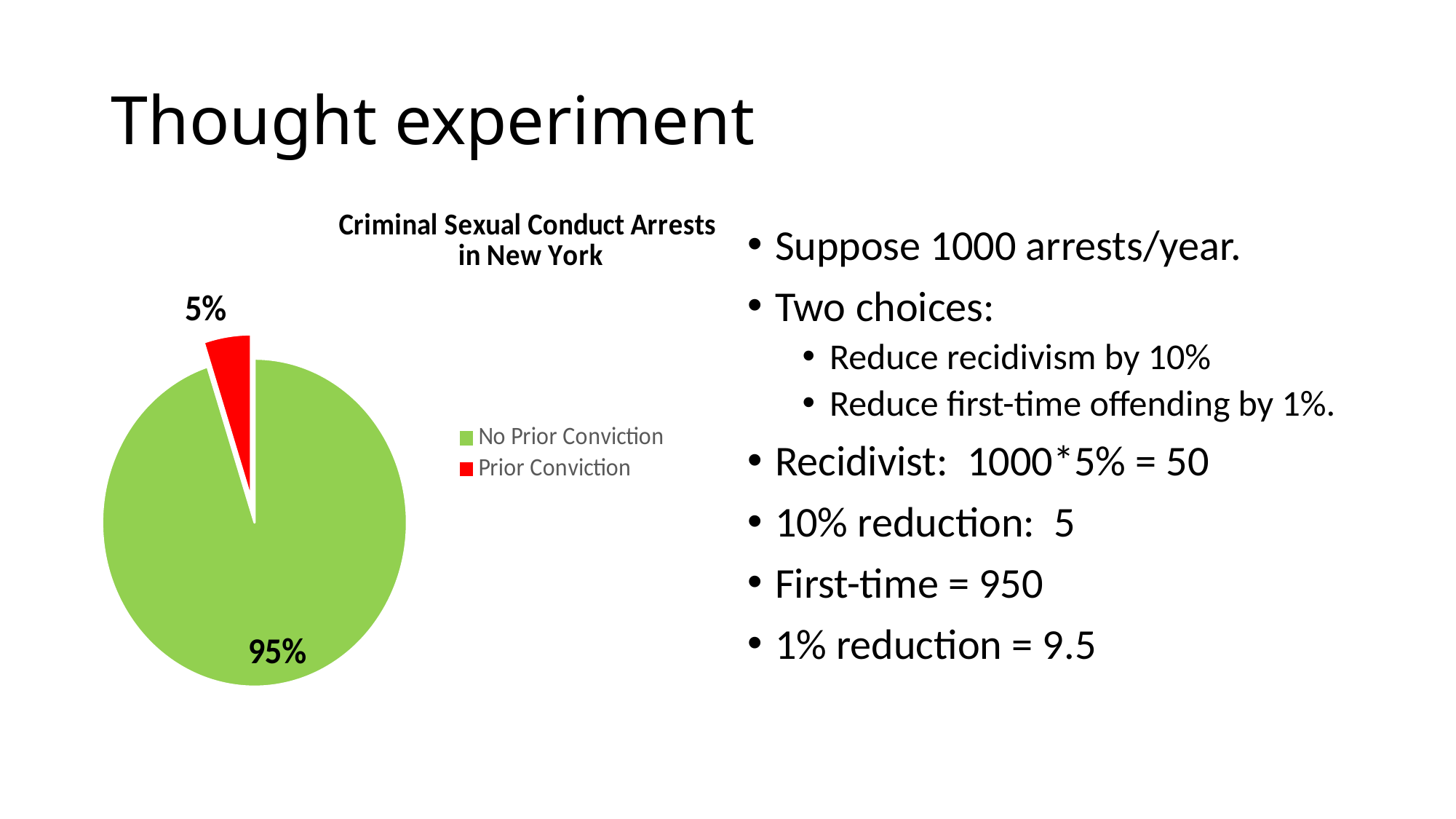
What share of arrests is labelled as Prior Conviction? 5% How many categories does the pie chart show? 2 What is the difference in percentage points between the No Prior Conviction and Prior Conviction slices? 90 How many entries does the legend list? 2 What is the title of the chart? Criminal Sexual Conduct Arrests in New York Which category has the smallest slice of the pie? Prior Conviction What colour is the Prior Conviction slice? red What kind of chart is shown on the slide? pie chart What share of arrests is labelled as No Prior Conviction? 95% Which is larger, the No Prior Conviction slice or the Prior Conviction slice? No Prior Conviction Which category has the largest slice of the pie? No Prior Conviction